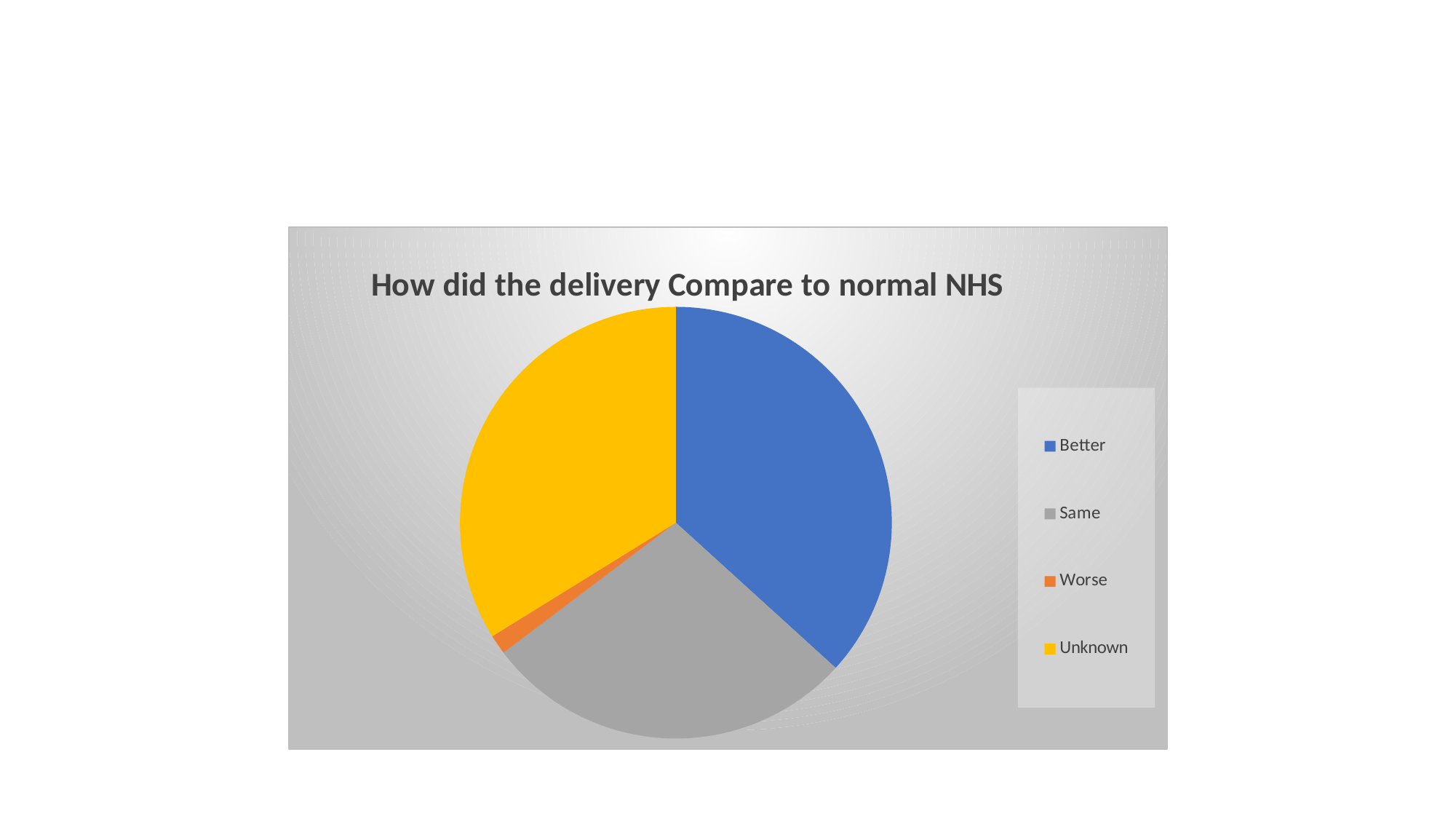
Which colour represents the Unknown category in the pie chart? yellow What is the title of the chart? How did the delivery Compare to normal NHS Which slice is larger, Better or Same? Better How many entries does the legend list? 4 How many categories does the pie chart have? 4 Which slice is larger, Same or Worse? Same What kind of chart is shown on the slide? pie chart Which category has the smallest slice of the pie? Worse Which slice is larger, Worse or Unknown? Unknown